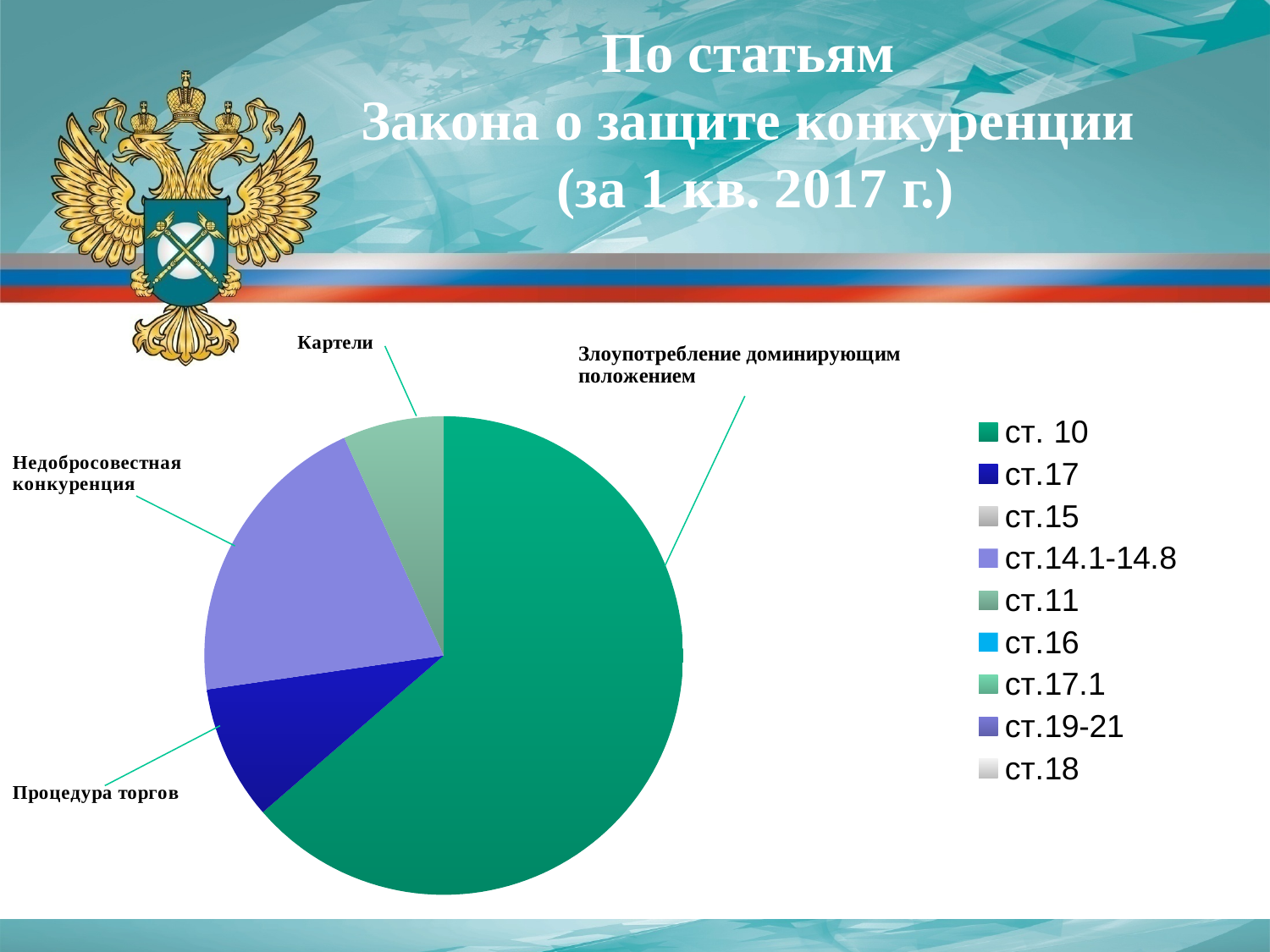
Which legend category has the largest slice in the pie chart? ст. 10 Does the ст. 10 slice take up more or less than half of the pie? more Which slice is larger: ст.17 or ст.11? ст.17 Which slice is larger: ст.14.1-14.8 or ст.17? ст.14.1-14.8 Which callout label is attached to the largest slice of the pie? Злоупотребление доминирующим положением What is the title of the slide containing the pie chart? По статьям Закона о защите конкуренции (за 1 кв. 2017 г.) How many slices are visible in the pie chart? 4 What colour is the ст. 10 slice in the pie chart? green Which callout label points to the smallest visible slice of the pie? Картели What kind of chart is shown on the slide? pie chart Which slice is larger: ст. 10 or ст.14.1-14.8? ст. 10 How many entries does the legend of the pie chart list? 9